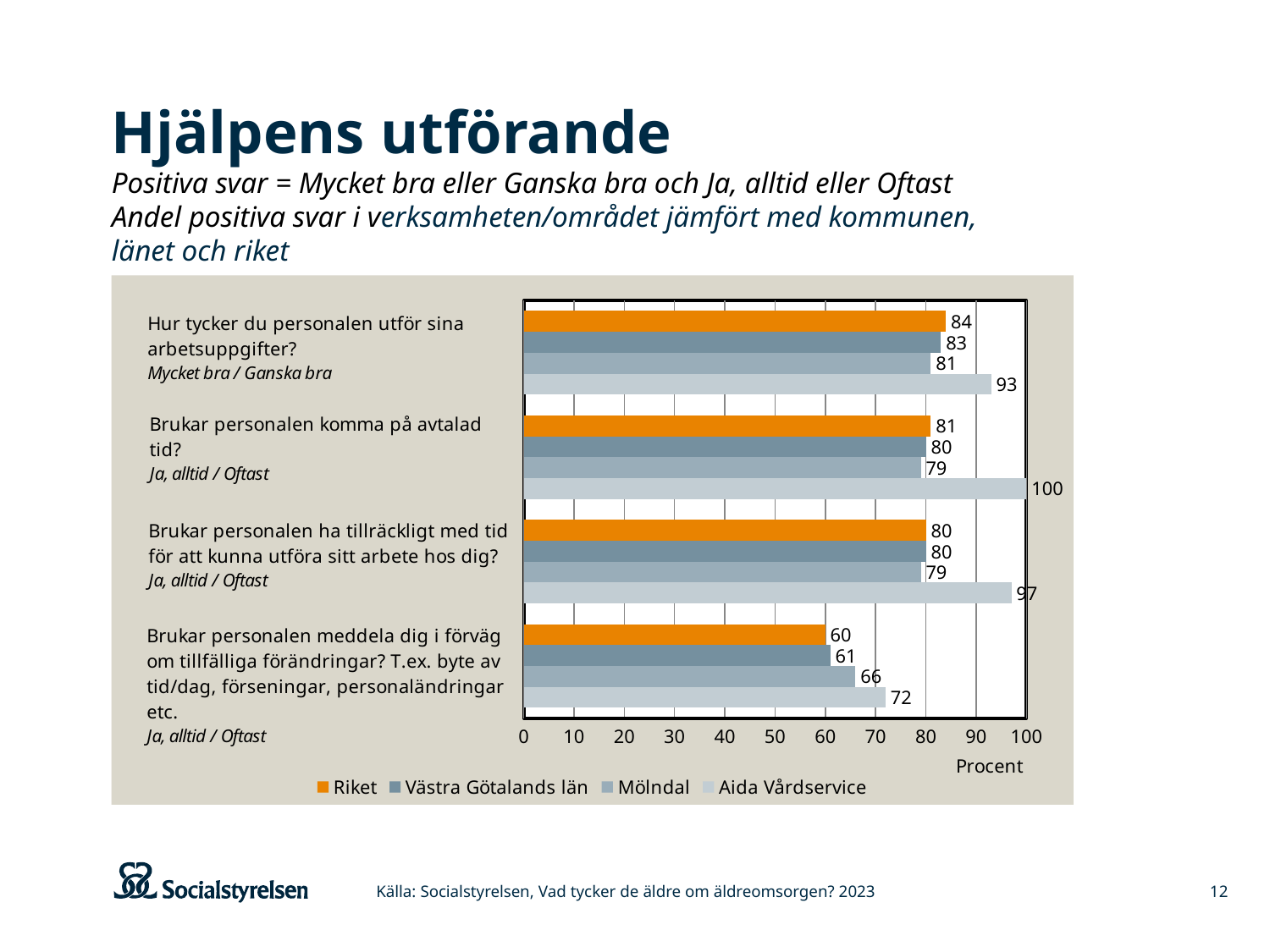
What is the value for Mölndal on the question "Brukar personalen meddela dig i förväg om tillfälliga förändringar?"? 66 What is the value for Västra Götalands län on the question "Brukar personalen ha tillräckligt med tid för att kunna utföra sitt arbete hos dig?"? 80 What kind of chart is shown on the slide? Bar chart How many questions (categories) are shown in the chart? 4 What is the difference between Aida Vårdservice and Riket on the question "Brukar personalen ha tillräckligt med tid för att kunna utföra sitt arbete hos dig?"? 17 How many series does the legend list? 4 What is the label on the horizontal axis of the chart? Procent Which question has the lowest value for Aida Vårdservice? Brukar personalen meddela dig i förväg om tillfälliga förändringar? What is the value for Riket on the question "Hur tycker du personalen utför sina arbetsuppgifter?"? 84 What is the value for Aida Vårdservice on the question "Brukar personalen komma på avtalad tid?"? 100 On the question "Brukar personalen meddela dig i förväg om tillfälliga förändringar?", which is larger: Riket or Aida Vårdservice? Aida Vårdservice Which question has the highest value for Riket? Hur tycker du personalen utför sina arbetsuppgifter?